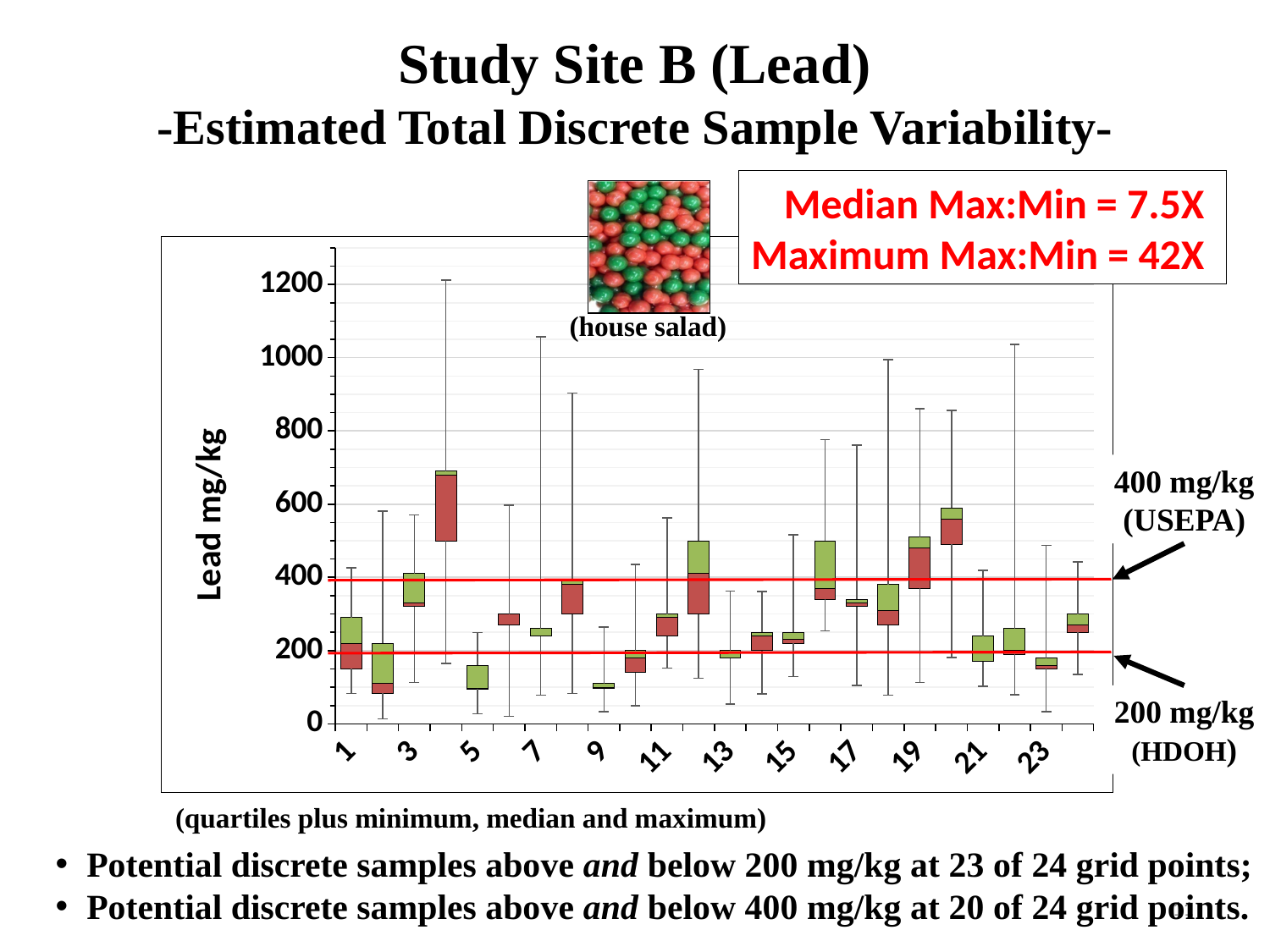
What is the highest tick value shown on the y-axis? 1200 Which grid point has the highest maximum value? Grid point 4 How many grid points (boxes) are plotted along the x-axis? 24 Which grid point has the lowest maximum value? Grid point 9 What is the label of the y-axis? Lead mg/kg Is the median value for grid point 9 greater or less than 200 mg/kg? less Is the median value for grid point 4 greater or less than 400 mg/kg? greater What kind of chart is shown on the slide? Box-and-whisker (box plot) chart Is the maximum value for grid point 4 greater or less than 1000 mg/kg? greater At what lead concentration is the USEPA reference line drawn? 400 mg/kg Which grid point has a higher maximum value, grid point 7 or grid point 9? Grid point 7